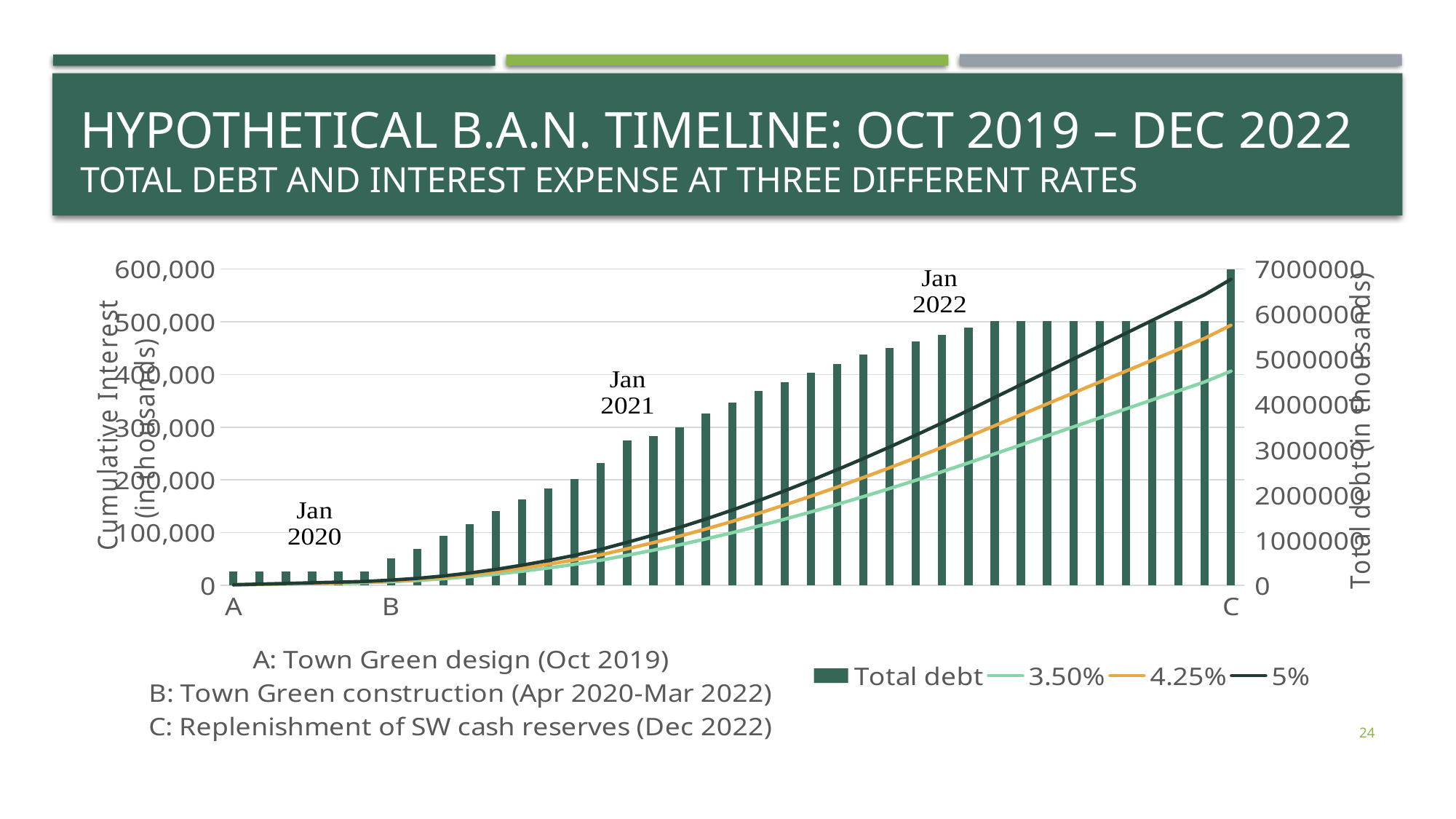
At point C, is the cumulative interest for the 3.50% line greater or less than 500,000? less Which rate line shows the lowest cumulative interest at point C? 3.50% Do the cumulative interest lines rise or fall from A to C? Rise Which rate line shows the highest cumulative interest at point C? 5% Is the Total debt bar at point C greater or less than 6000000? greater What kind of chart is shown on the slide? Combined bar and line chart At point C, which is larger: the cumulative interest for the 4.25% line or the 3.50% line? 4.25% How many series does the chart legend list? 4 At point C, is the cumulative interest for the 4.25% line greater or less than 400,000? greater What are the three interest rates shown as lines in the legend? 3.50%, 4.25%, 5% Which series is plotted as bars? Total debt